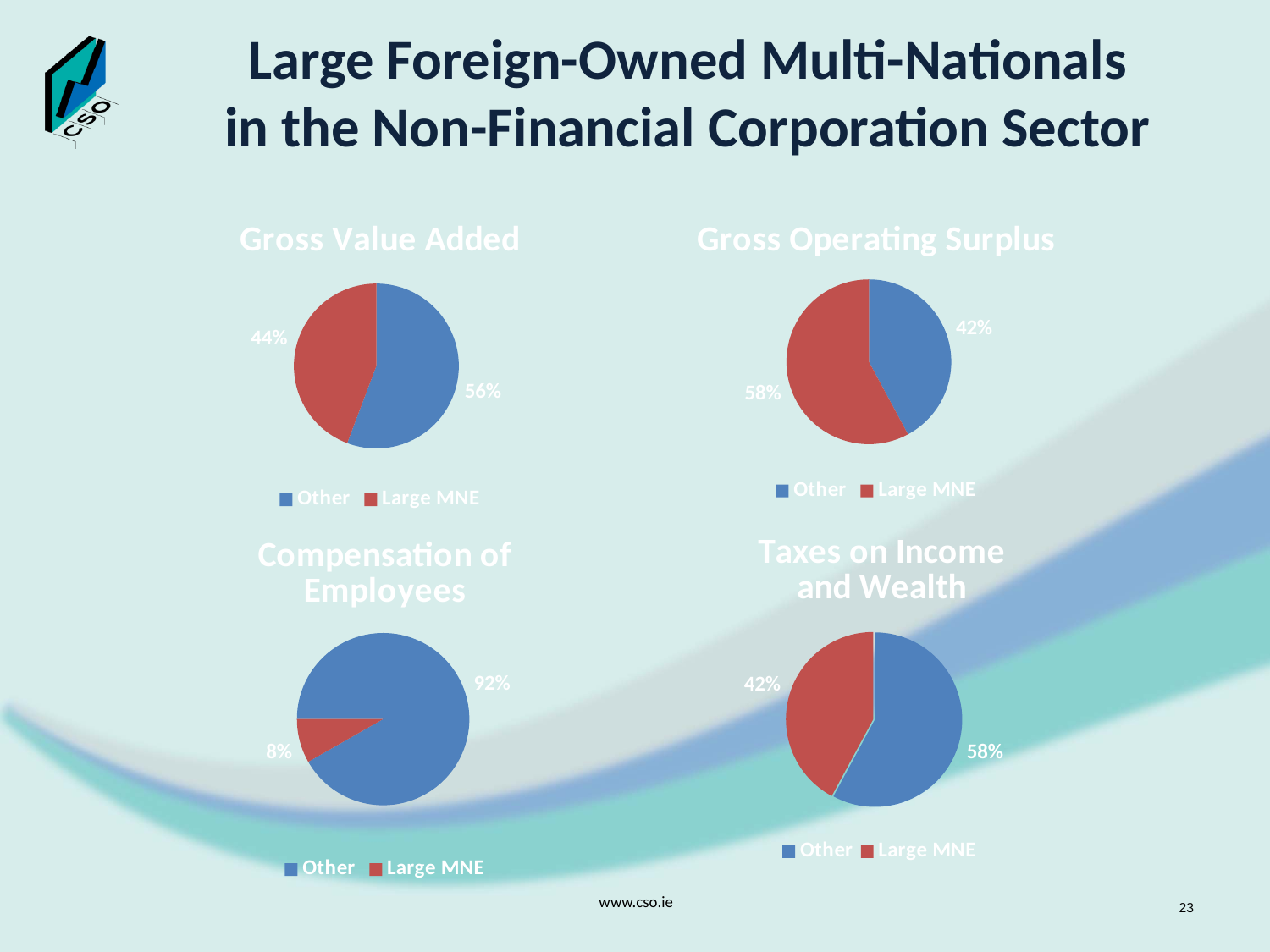
In the Gross Value Added chart, what share is Other? 56% In the Gross Value Added chart, what is the difference between the Other and Large MNE shares? 12 percentage points How many charts are shown on the slide? 4 In the Compensation of Employees chart, what share is Large MNE? 8% In the Gross Value Added chart, what share is Large MNE? 44% What kind of chart is the Gross Operating Surplus chart? Pie chart In the Taxes on Income and Wealth chart, what share is Other? 58% In the Gross Operating Surplus chart, which slice is smallest? Other In the Compensation of Employees chart, what is the difference between the Other and Large MNE shares? 84 percentage points In the Compensation of Employees chart, which slice is largest? Other In the Gross Operating Surplus chart, what share is Large MNE? 58% In the Taxes on Income and Wealth chart, which is larger, Other or Large MNE? Other